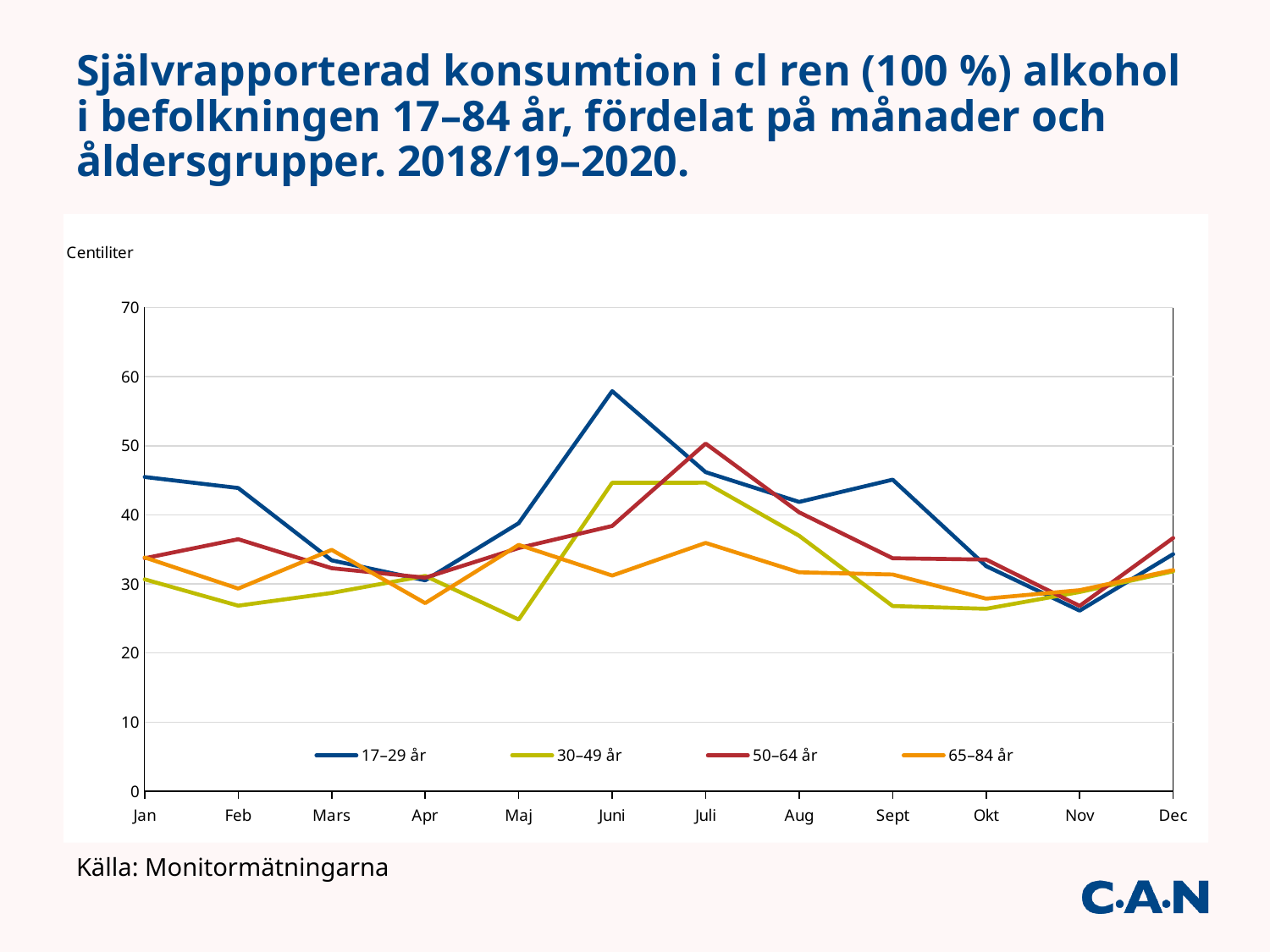
What kind of chart is shown on the slide? Line chart What unit label is shown above the y axis? Centiliter How many series does the legend list? 4 How many months are shown along the x axis? 12 Is the value for 17–29 år in Juni greater or less than 50? greater Is the value for 30–49 år in Maj greater or less than 30? less Does the 17–29 år series rise or fall from Sept to Nov? Fall In which month does the 17–29 år series reach its highest value? Juni In Juni, which series has the higher value: 17–29 år or 30–49 år? 17–29 år In which month does the 50–64 år series reach its highest value? Juli In Juli, which series has the higher value: 50–64 år or 65–84 år? 50–64 år In which month does the 17–29 år series reach its lowest value? Nov